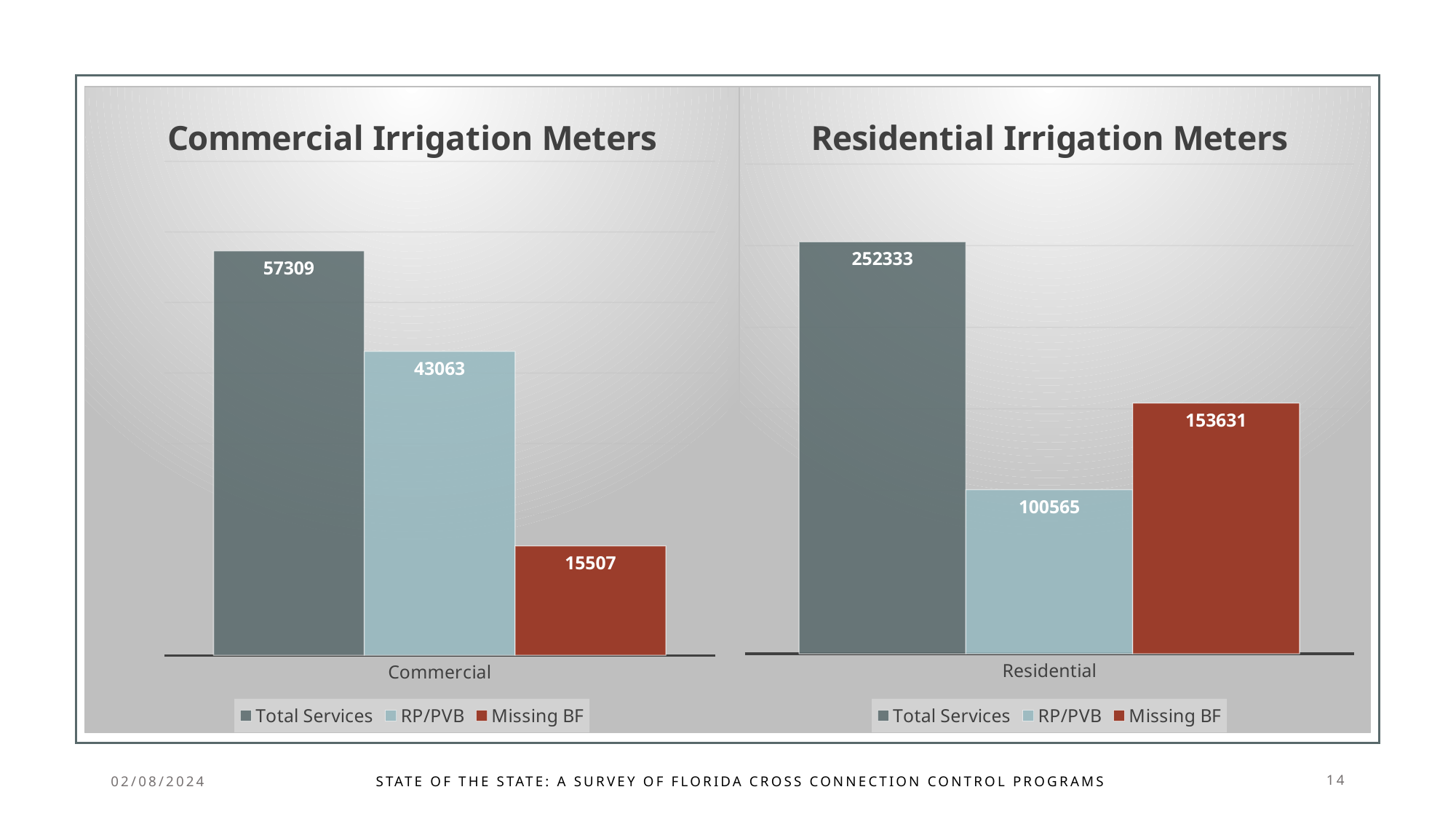
In the Residential Irrigation Meters chart, what is the value for Total Services? 252333 In the Residential Irrigation Meters chart, which is larger, RP/PVB or Missing BF? Missing BF In the Residential Irrigation Meters chart, which series has the highest value? Total Services In the Commercial Irrigation Meters chart, what is the difference between Total Services and RP/PVB? 14246 In the Commercial Irrigation Meters chart, what is the value for RP/PVB? 43063 In the Commercial Irrigation Meters chart, what is the value for Total Services? 57309 In the Commercial Irrigation Meters chart, what is the value for Missing BF? 15507 What kind of chart is the Commercial Irrigation Meters chart? Bar chart How many series does the legend of the Residential Irrigation Meters chart list? 3 In the Residential Irrigation Meters chart, what is the value for Missing BF? 153631 In the Residential Irrigation Meters chart, what is the value for RP/PVB? 100565 In the Commercial Irrigation Meters chart, which series has the lowest value? Missing BF